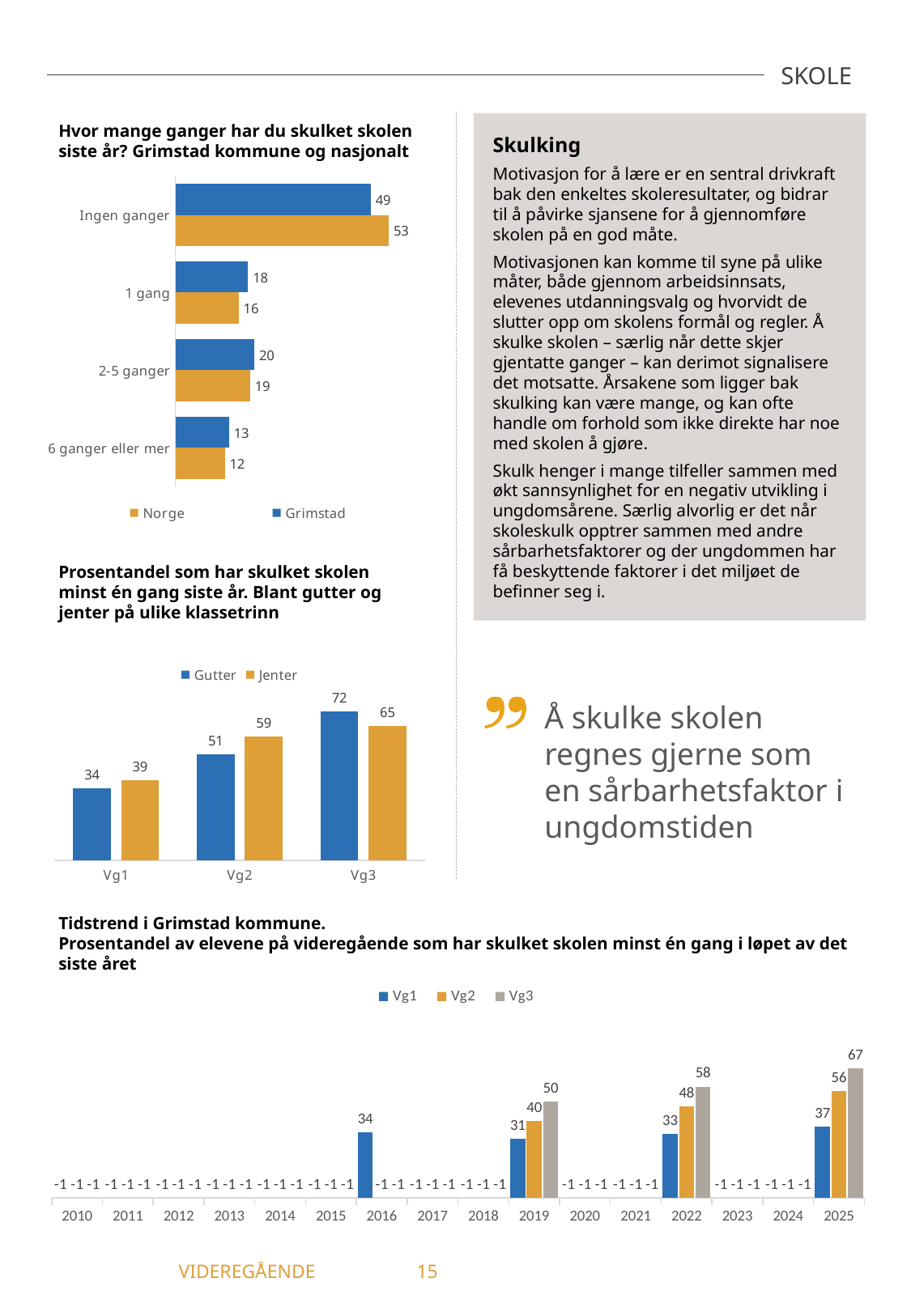
In the chart 'Prosentandel som har skulket skolen minst én gang siste år', what is the value for Jenter at Vg2? 59 In the chart 'Hvor mange ganger har du skulket skolen siste år?', how many categories are shown? 4 In the chart 'Prosentandel som har skulket skolen minst én gang siste år', which class level has the highest value for Gutter? Vg3 In the chart 'Hvor mange ganger har du skulket skolen siste år?', what is the value for Grimstad in the category '6 ganger eller mer'? 13 In the chart 'Tidstrend i Grimstad kommune', how many series does the legend list? 3 In the chart 'Hvor mange ganger har du skulket skolen siste år?', what is the difference between Norge and Grimstad for 'Ingen ganger'? 4 In the chart 'Tidstrend i Grimstad kommune', what is the value for Vg3 in 2025? 67 In the chart 'Hvor mange ganger har du skulket skolen siste år?', what is the value for Norge in the category 'Ingen ganger'? 53 In the chart 'Prosentandel som har skulket skolen minst én gang siste år', which is larger at Vg3: Gutter or Jenter? Gutter In the chart 'Tidstrend i Grimstad kommune', what is the value for Vg1 in 2016? 34 What kind of chart is 'Tidstrend i Grimstad kommune'? Bar chart In the chart 'Prosentandel som har skulket skolen minst én gang siste år', do the values for Gutter rise or fall from Vg1 to Vg3? Rise